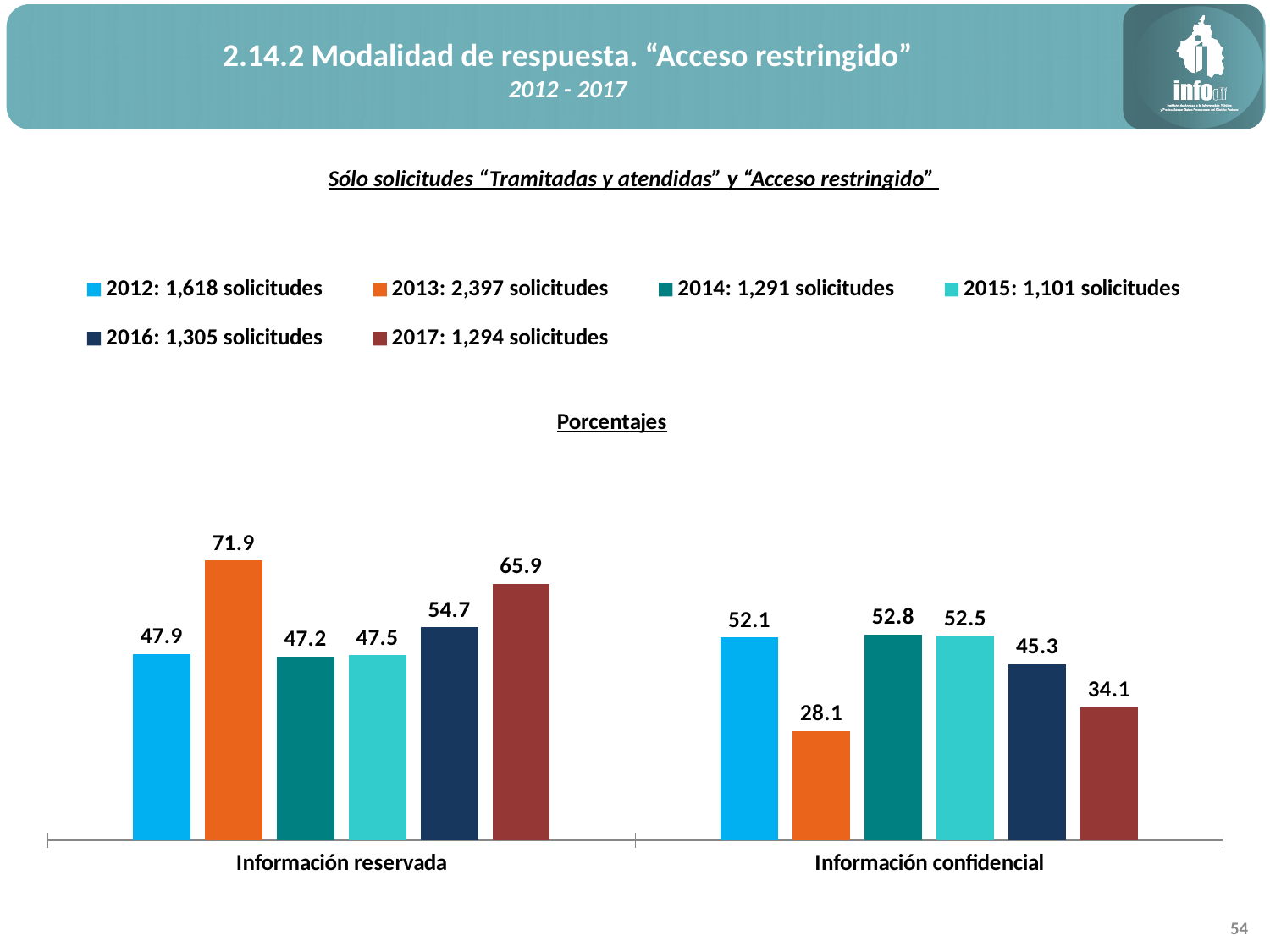
What is the value for 2013 in the Información reservada category? 71.9 Which year has the highest value in the Información reservada category? 2013 How many series does the legend list? 6 According to the legend, how many solicitudes were there in 2013? 2,397 What is the value for 2017 in the Información confidencial category? 34.1 What is the difference between the 2013 and 2012 values in the Información reservada category? 24 What kind of chart is shown on the slide? bar chart What is the value for 2016 in the Información reservada category? 54.7 What is the difference between the 2014 and 2017 values in the Información confidencial category? 18.7 How many categories are shown on the x axis? 2 Which is larger: the 2017 value for Información reservada or the 2017 value for Información confidencial? Información reservada Which year has the lowest value in the Información confidencial category? 2013